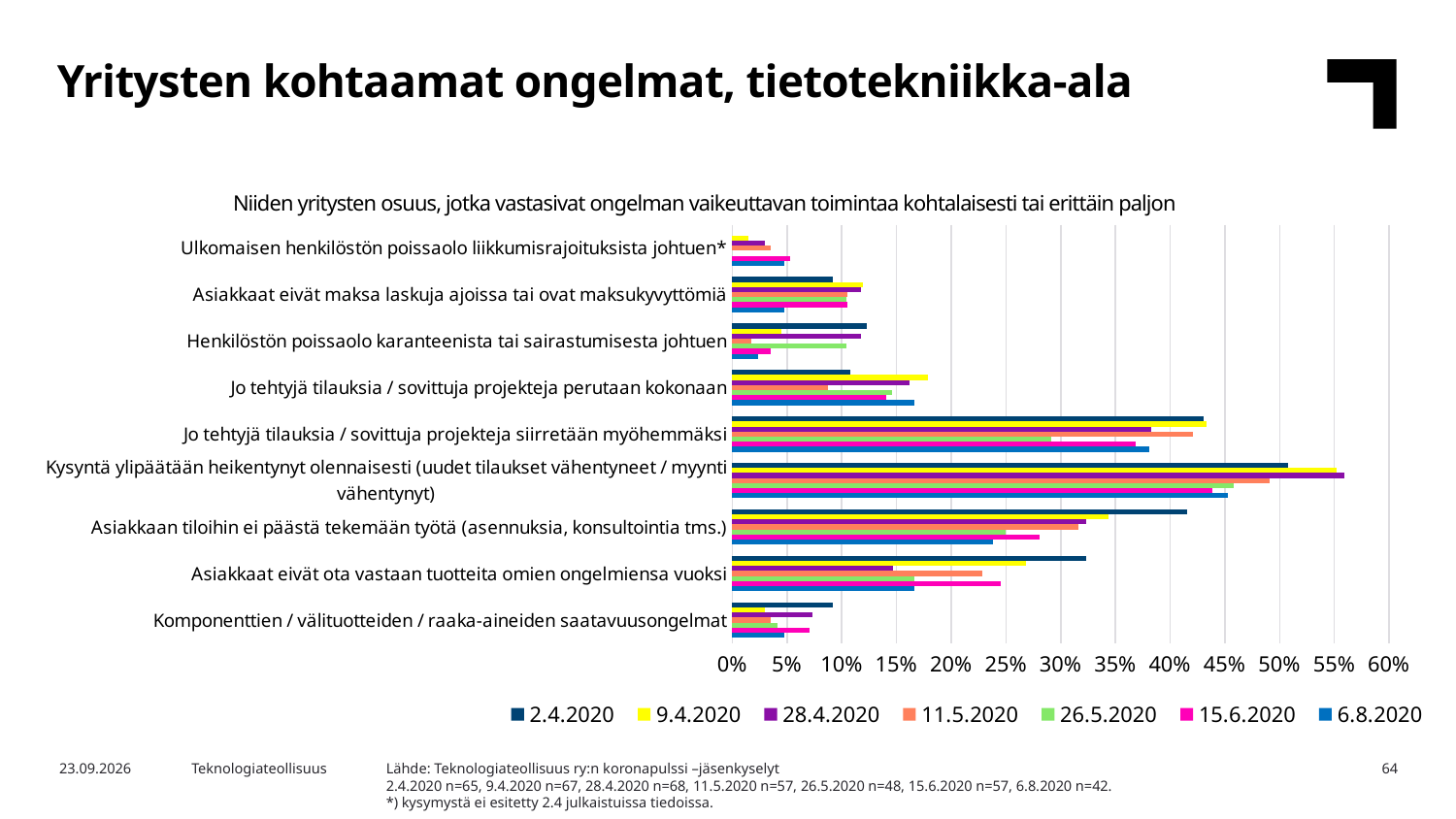
What is the title of the slide? Yritysten kohtaamat ongelmat, tietotekniikka-ala How many series does the chart legend list? 7 Is the value for 'Henkilöstön poissaolo karanteenista tai sairastumisesta johtuen' in the 6.8.2020 series greater or less than 5%? less Is the value for 'Komponenttien / välituotteiden / raaka-aineiden saatavuusongelmat' in the 2.4.2020 series greater or less than 10%? less What kind of chart is shown on the slide? Bar chart Is the value for 'Kysyntä ylipäätään heikentynyt olennaisesti' in the 28.4.2020 series greater or less than 50%? greater For 'Asiakkaat eivät ota vastaan tuotteita omien ongelmiensa vuoksi', which is larger: the 9.4.2020 value or the 28.4.2020 value? 9.4.2020 How many categories (problem types) are listed on the chart? 9 Which category has the highest value in the 2.4.2020 series? Kysyntä ylipäätään heikentynyt olennaisesti (uudet tilaukset vähentyneet / myynti vähentynyt) For 'Jo tehtyjä tilauksia / sovittuja projekteja siirretään myöhemmäksi', which is larger: the 26.5.2020 value or the 15.6.2020 value? 15.6.2020